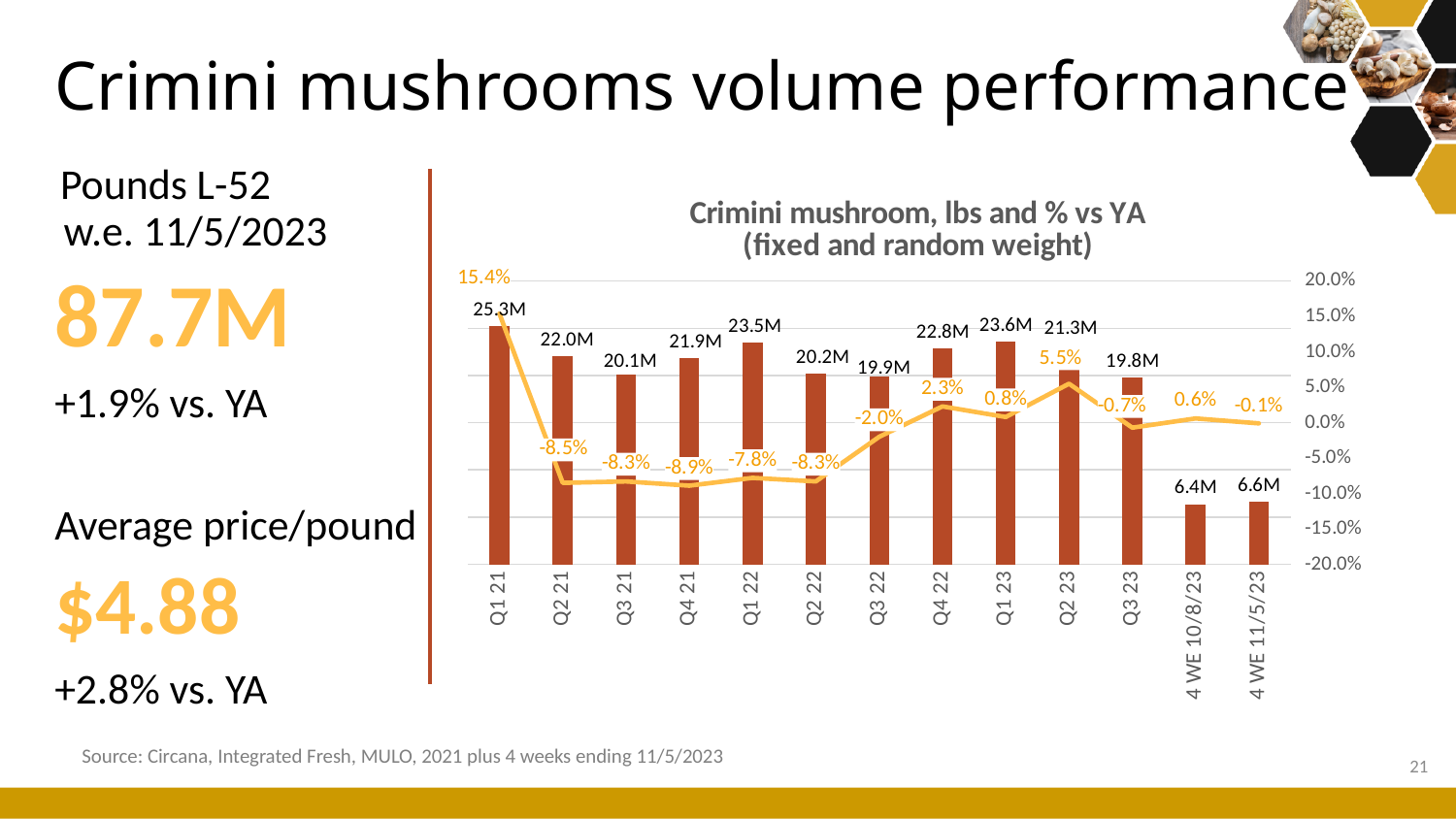
What is the title of the chart? Crimini mushroom, lbs and % vs YA (fixed and random weight) What kind of chart is this? Combination bar and line chart What is the % vs YA value for Q2 23? 5.5% How many categories are shown on the x axis? 13 Which quarter has the highest volume in pounds? Q1 21 What is the difference between the % vs YA values for Q1 21 and Q2 21? 23.9 percentage points What is the difference in pounds between Q1 23 and Q3 23? 3.8M What is the % vs YA value for Q3 22? -2.0% Which category has the lowest % vs YA value? Q4 21 What is the volume in pounds for Q1 21? 25.3M What is the volume in pounds for the 4 WE 11/5/23 period? 6.6M Which has a higher volume in pounds, Q4 22 or Q2 23? Q4 22